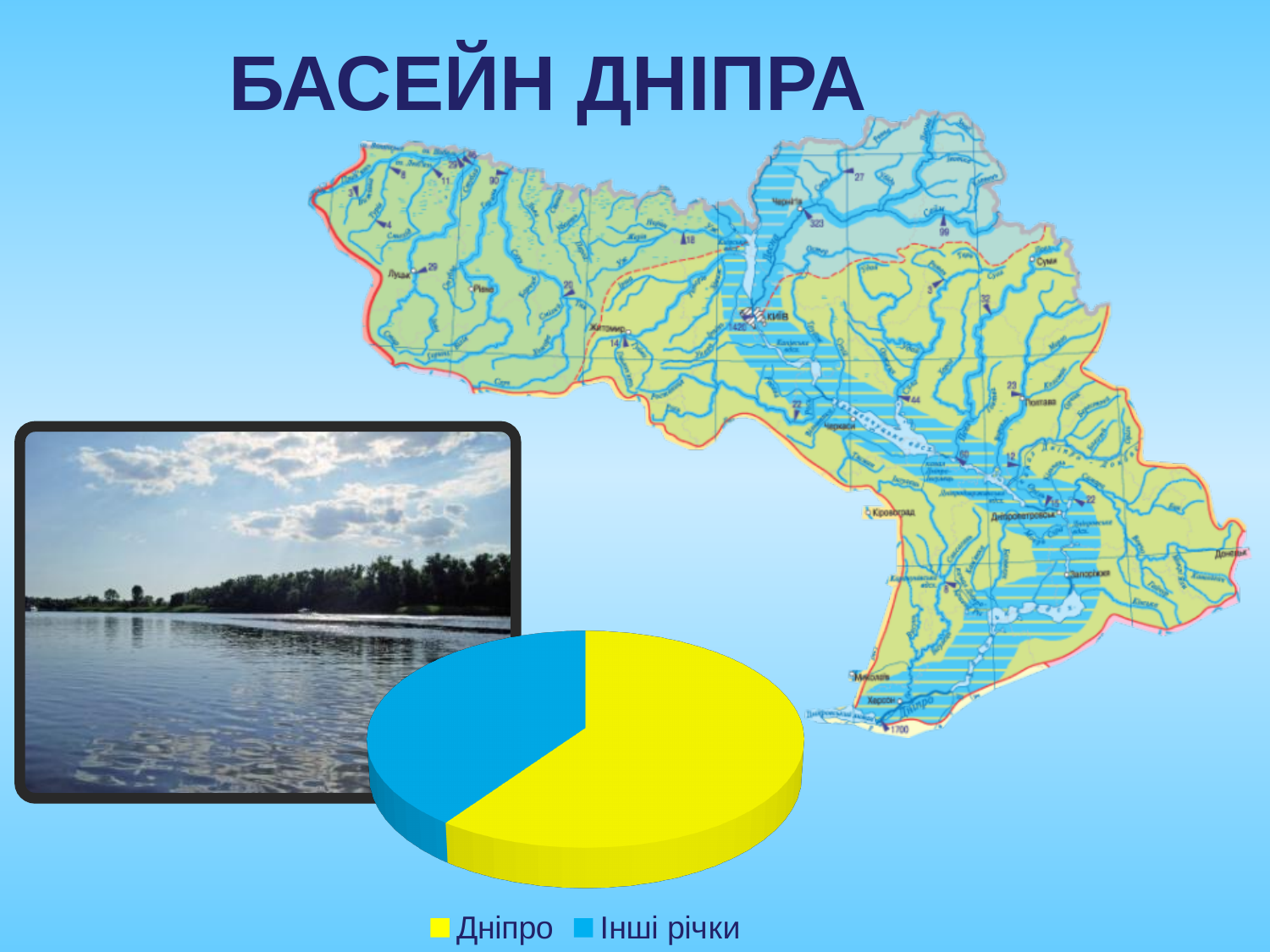
Which slice is larger in the pie chart, Дніпро or Інші річки? Дніпро Which category has the largest slice in the pie chart? Дніпро How many entries does the legend of the pie chart list? 2 How many slices does the pie chart have? 2 What kind of chart is shown on the slide? pie chart What colour is the Дніпро slice in the pie chart? yellow What colour is the Інші річки slice in the pie chart? blue Which category has the smallest slice in the pie chart? Інші річки